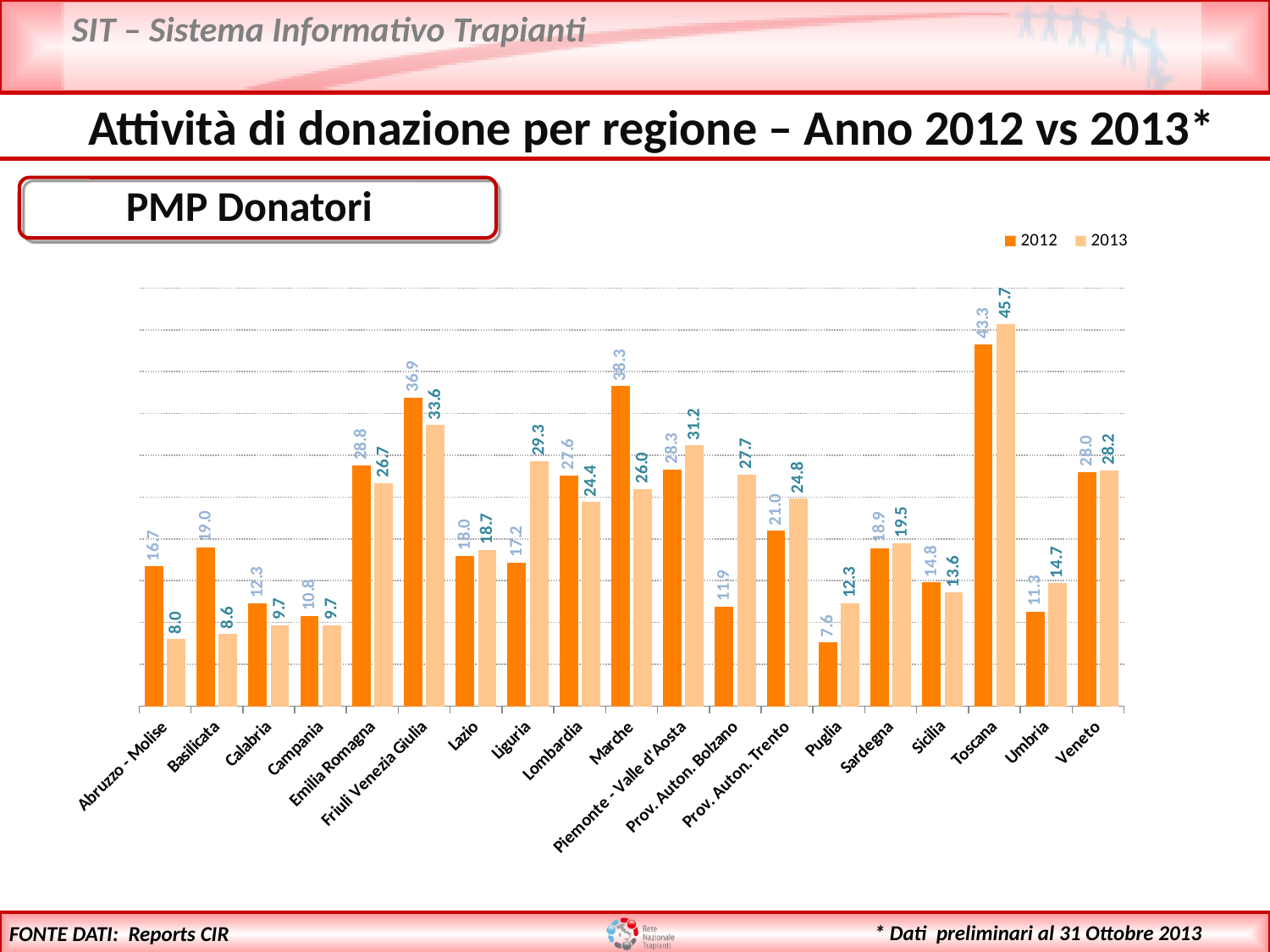
What is the 2013 value for Toscana? 45.7 Which series is shown in the darker orange colour? 2012 Which is larger for Friuli Venezia Giulia, the 2012 value or the 2013 value? 2012 What is the difference between the 2012 and 2013 values for Liguria? 12.1 What is the 2013 value for Prov. Auton. Bolzano? 27.7 What is the 2012 value for Marche? 38.3 What type of chart is shown on the slide? bar chart How many series does the legend list? 2 What is the difference between the 2012 value for Abruzzo - Molise and its 2013 value? 8.7 How many regions are shown on the x axis? 19 Which region has the highest 2012 value? Toscana Which region has the lowest 2013 value? Abruzzo - Molise